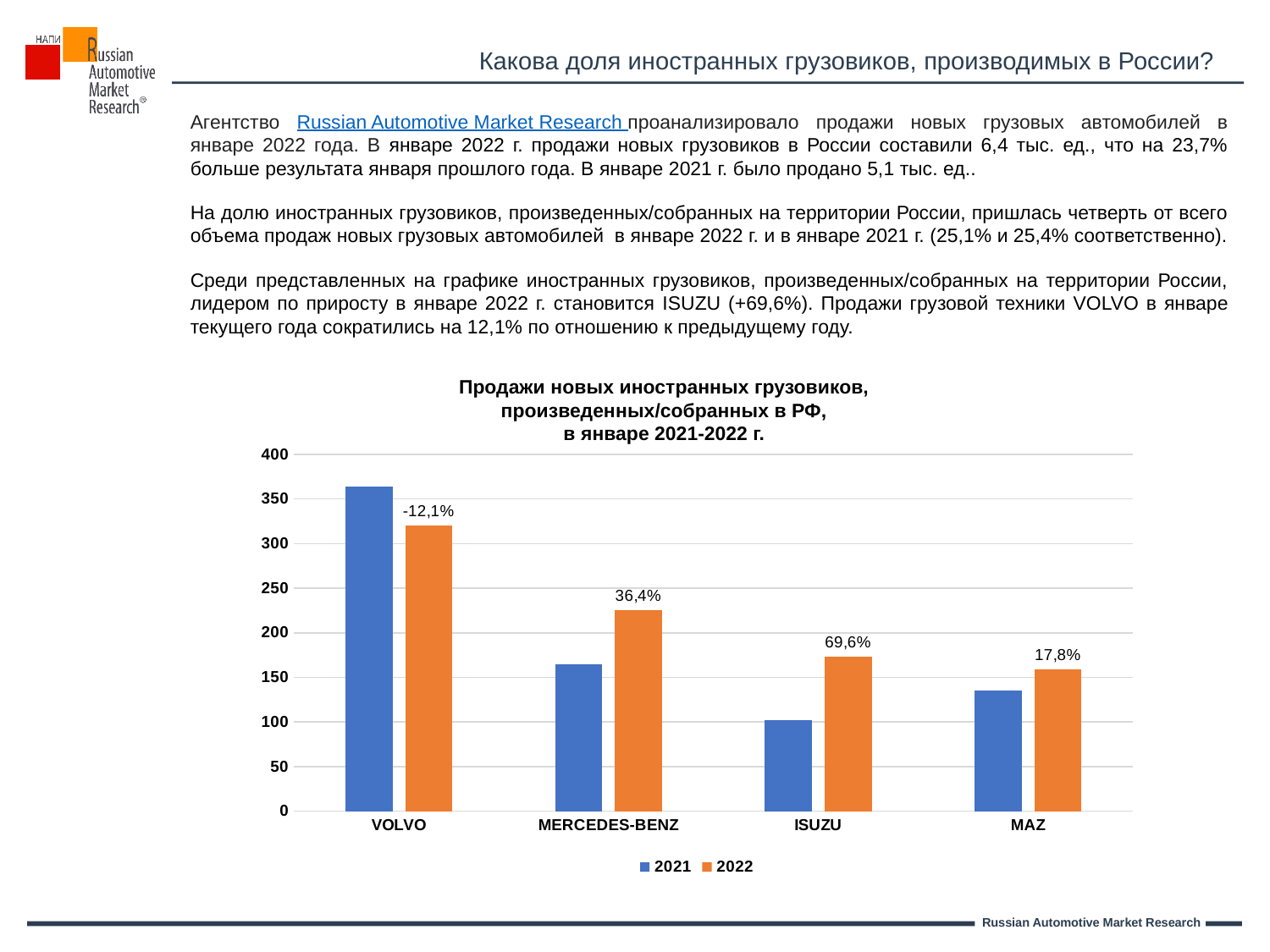
Which brand has the highest 2021 bar in the chart? VOLVO What kind of chart is shown on the slide? bar chart What percentage change is labelled above the 2022 bar for VOLVO? -12,1% For MERCEDES-BENZ, which year has the larger bar, 2021 or 2022? 2022 Is the 2021 value for ISUZU greater or less than 150? less Is the 2021 value for VOLVO greater or less than 350? greater What percentage change is labelled above the 2022 bar for MAZ? 17,8% What percentage change is labelled above the 2022 bar for ISUZU? 69,6% How many truck brands are shown on the x axis of the chart? 4 Which brand shows the largest percentage growth label in the chart? ISUZU How many series does the legend of the chart list? 2 Which brand has the lowest 2021 bar in the chart? ISUZU